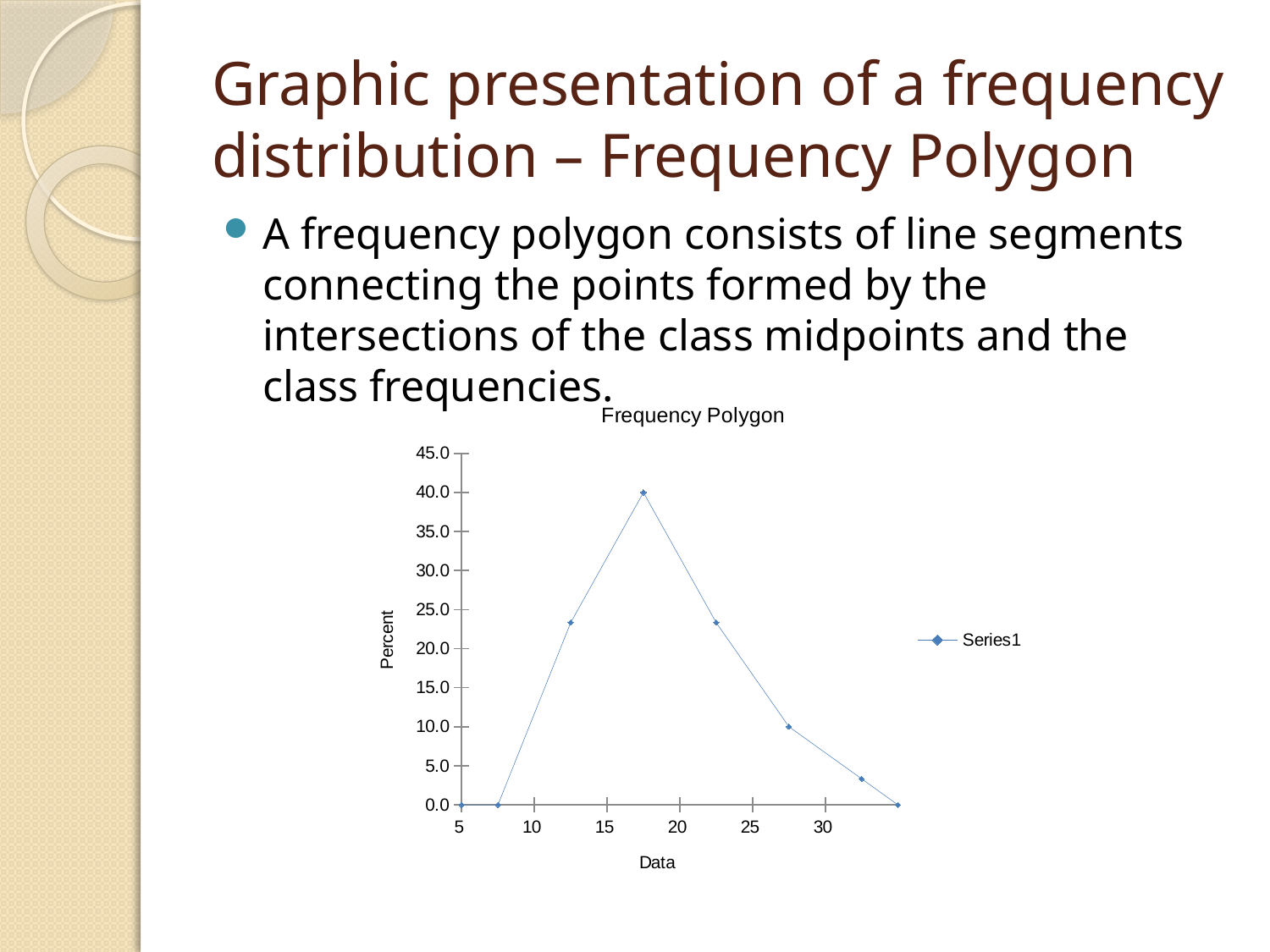
Is the value of the point between 10 and 15 on the x axis greater or less than 20.0? greater What is the title of the chart? Frequency Polygon Do the values rise or fall along the x axis after the peak at the 40.0 point? fall What is the name of the series shown in the legend? Series1 What is the lowest value reached by the line? 0.0 Which is larger: the value of the point between 10 and 15 on the x axis, or the value of the point between 25 and 30? the point between 10 and 15 How many series does the legend list? 1 Is the value of the point between 30 and 35 on the x axis greater or less than 5.0? less Is the value of the point between 20 and 25 on the x axis greater or less than 30.0? less What kind of chart is shown on the slide? line chart What is the highest value reached by the line? 40.0 How many data points are plotted on the line? 8